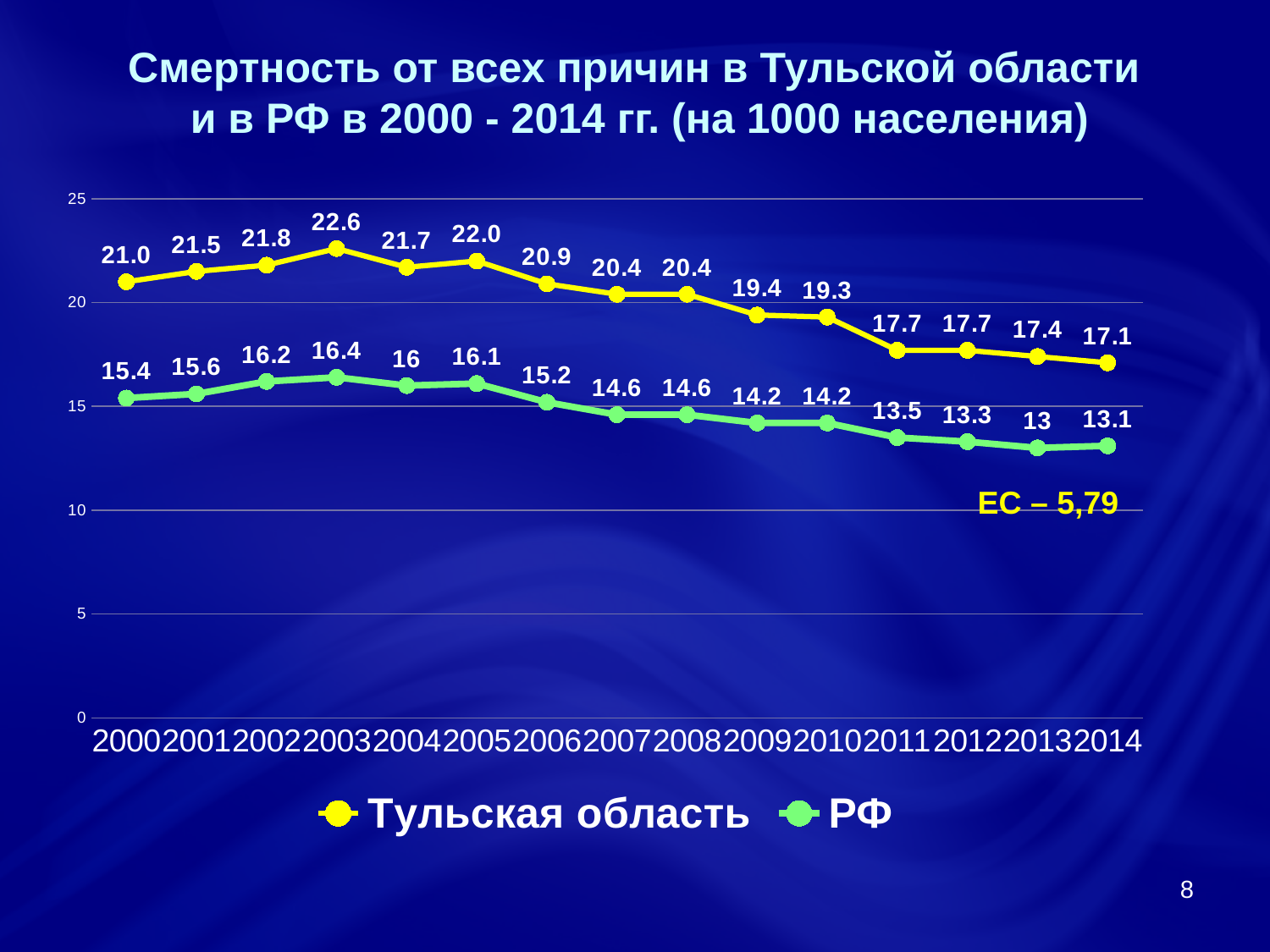
How many series does the legend list? 2 What is the value for РФ in 2014? 13.1 How many years are shown on the x axis? 15 Which is larger in 2005: the value for Тульская область or for РФ? Тульская область What is the difference between the Тульская область values in 2000 and 2014? 3.9 Do the values for РФ generally rise or fall from 2005 to 2014? fall What kind of chart is shown on the slide? line chart In which year is the value for Тульская область highest? 2003 What is the difference between the Тульская область and РФ values in 2014? 4.0 In which year is the value for РФ lowest? 2013 What is the value for Тульская область in 2003? 22.6 What is the value for Тульская область in 2010? 19.3